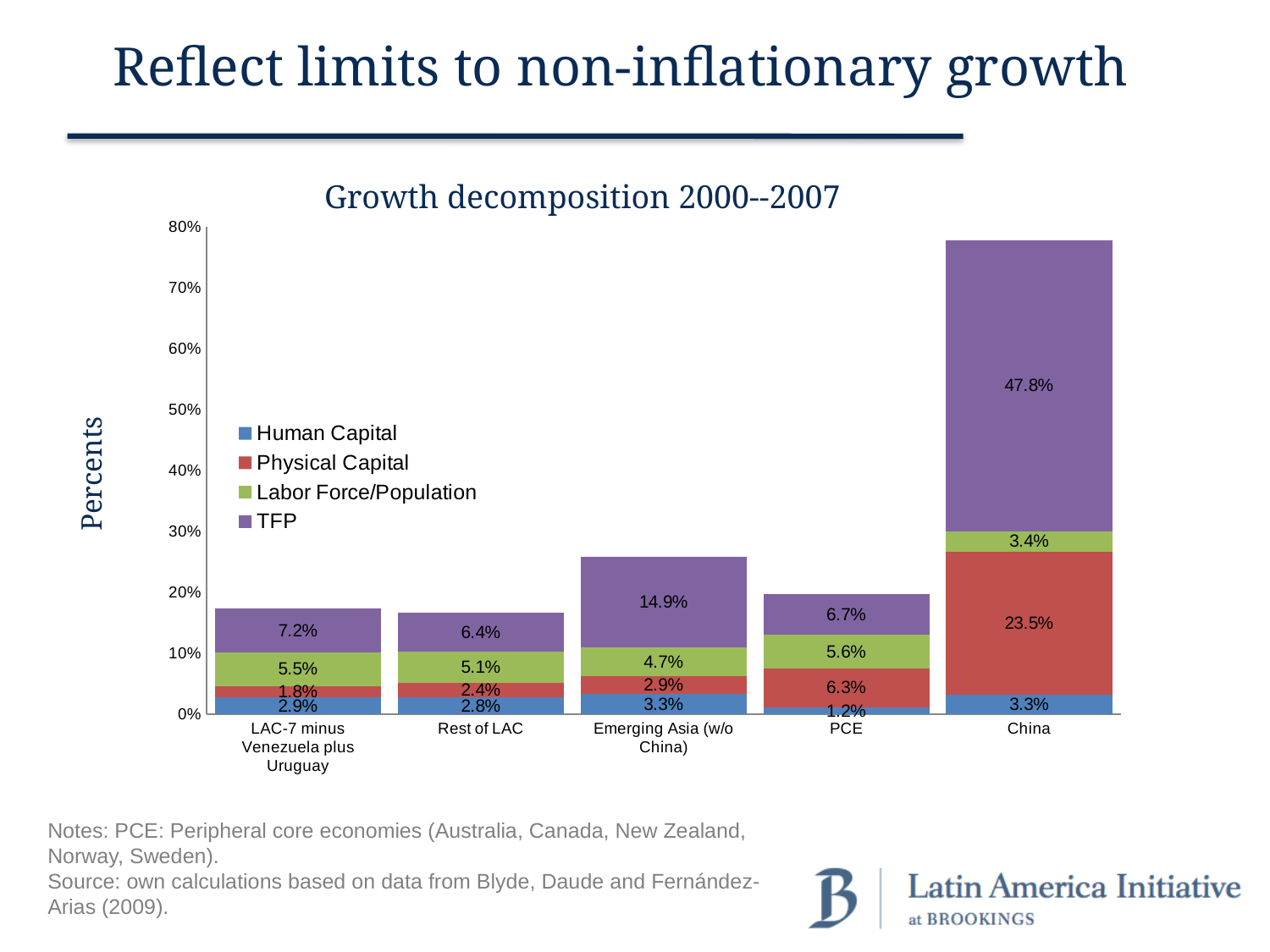
How many categories are shown on the x axis? 5 Which is larger: the Physical Capital value for PCE or the Physical Capital value for Rest of LAC? PCE How many series does the legend list? 4 What type of chart is shown on the slide? Stacked bar chart What is the Physical Capital value for PCE? 6.3% Which category has the highest TFP value? China What is the TFP value for China? 47.8% What is the difference between the TFP values for Emerging Asia (w/o China) and Rest of LAC? 8.5% What is the Human Capital value for Emerging Asia (w/o China)? 3.3% What is the total of the stacked bar for China? 78.0% What is the Labor Force/Population value for Rest of LAC? 5.1% Which category has the lowest Human Capital value? PCE